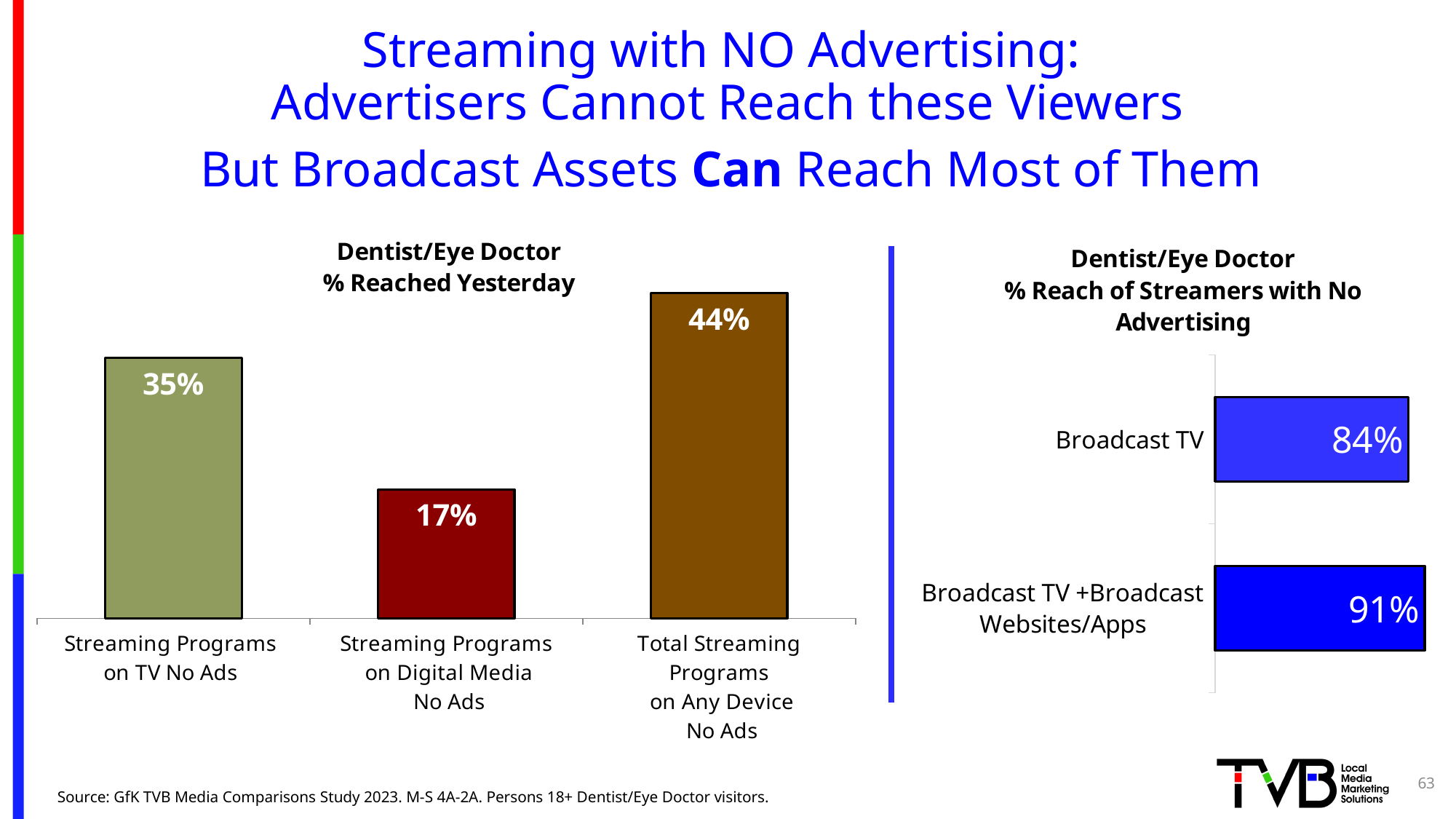
In the '% Reach of Streamers with No Advertising' chart, what is the value for Broadcast TV + Broadcast Websites/Apps? 91% In the '% Reached Yesterday' chart, how many categories are shown? 3 In the '% Reached Yesterday' chart, which category has the lowest value? Streaming Programs on Digital Media No Ads In the '% Reach of Streamers with No Advertising' chart, what is the difference between Broadcast TV + Broadcast Websites/Apps and Broadcast TV? 7% In the '% Reach of Streamers with No Advertising' chart, what is the value for Broadcast TV? 84% In the '% Reached Yesterday' chart, what is the value for Streaming Programs on TV No Ads? 35% In the '% Reached Yesterday' chart, which category has the highest value? Total Streaming Programs on Any Device No Ads In the '% Reach of Streamers with No Advertising' chart, which is larger: Broadcast TV or Broadcast TV + Broadcast Websites/Apps? Broadcast TV + Broadcast Websites/Apps In the '% Reached Yesterday' chart, what is the value for Total Streaming Programs on Any Device No Ads? 44% In the '% Reached Yesterday' chart, what is the difference between Streaming Programs on TV No Ads and Streaming Programs on Digital Media No Ads? 18% In the '% Reached Yesterday' chart, what is the value for Streaming Programs on Digital Media No Ads? 17% What type of chart is the '% Reach of Streamers with No Advertising' chart on the right? Bar chart